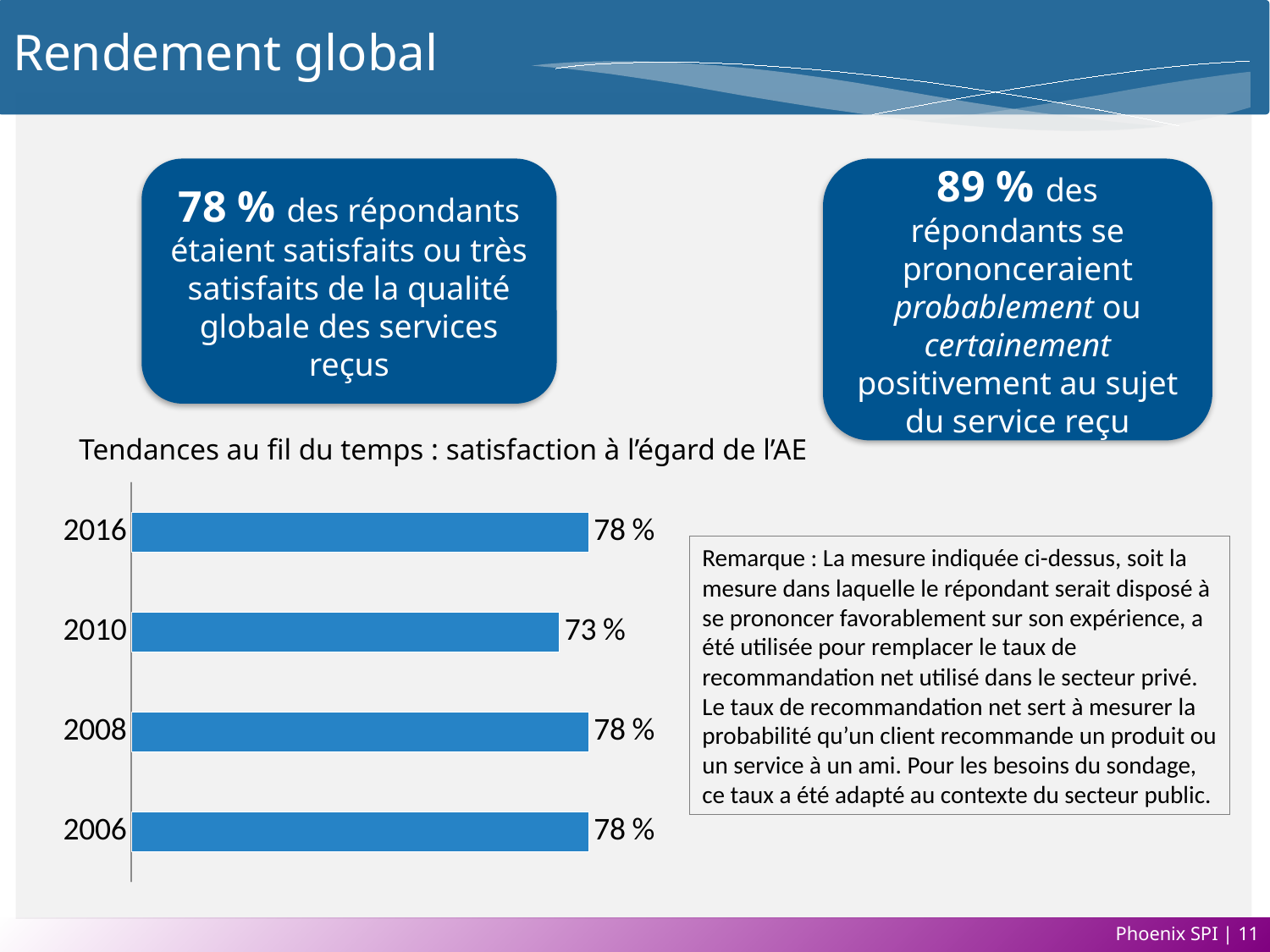
What is the title of the chart? Tendances au fil du temps : satisfaction à l’égard de l’AE How many years are shown in the chart? 4 What is the value for 2008? 78 % What kind of chart is shown? bar chart Did the value rise or fall from 2010 to 2016? rise What is the difference between the values for 2016 and 2010? 5 % What colour are the bars in the chart? blue What is the value for 2016? 78 % What is the value for 2006? 78 % Which year has the lowest value? 2010 What is the value for 2010? 73 % Which is larger, the value for 2010 or the value for 2008? 2008